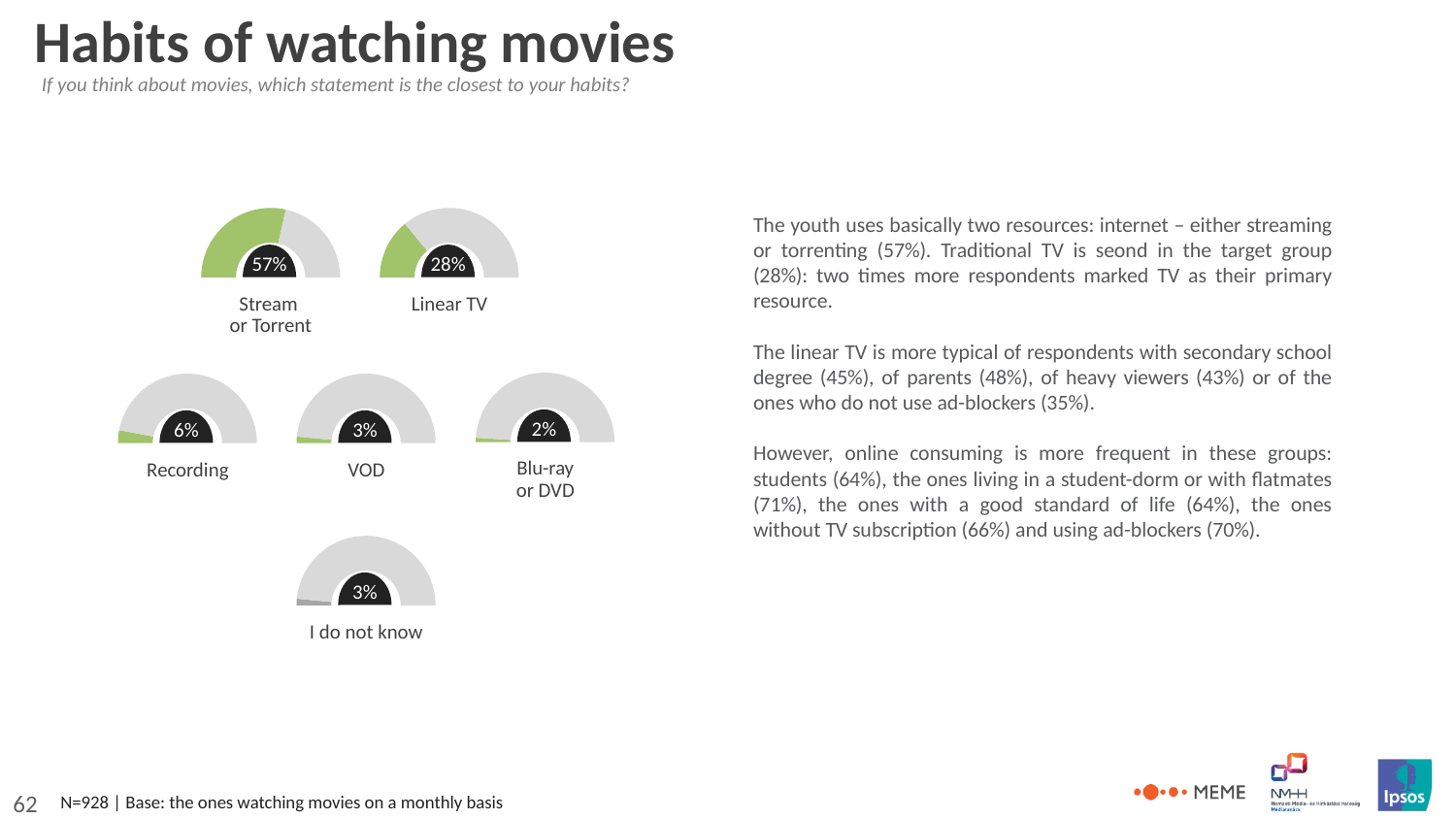
What percentage of respondents answered 'I do not know'? 3% What percentage of respondents chose Stream or Torrent as their movie-watching habit? 57% What is the title of the slide containing the charts? Habits of watching movies Which category has the highest value on the slide? Stream or Torrent Which is larger, the value for Recording or the value for VOD? Recording What percentage is shown for Recording? 6% Which category has the lowest value on the slide? Blu-ray or DVD What kind of chart is used to display each category's value? Gauge (half-doughnut) chart What is the difference in percentage points between Stream or Torrent and Linear TV? 29 percentage points How many categories (gauges) are shown on the slide? 6 What value is shown for Linear TV? 28% What value is shown for Blu-ray or DVD? 2%